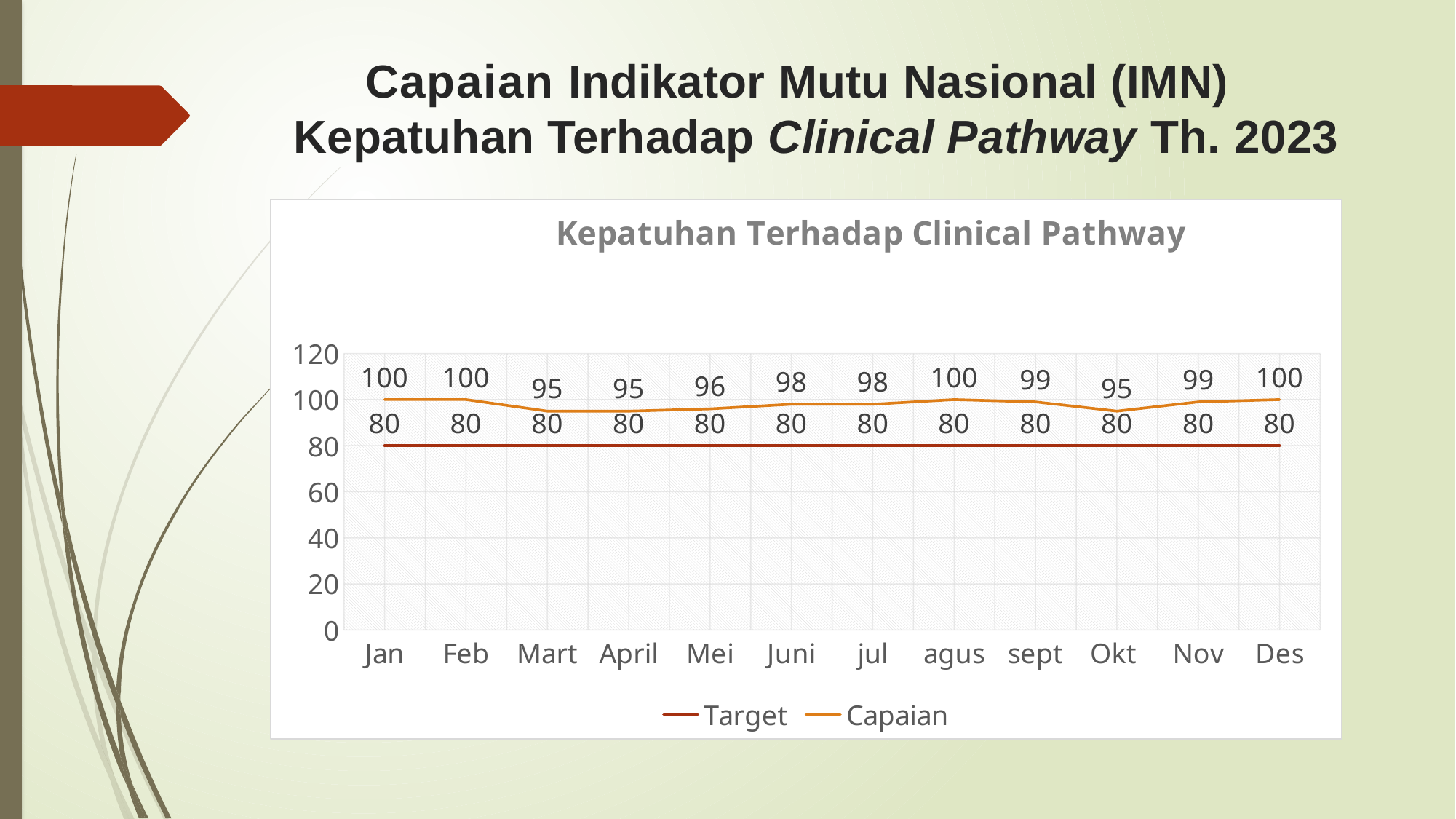
What is the Capaian value for sept? 99 What kind of chart is shown on the slide? Line chart Which month has the lowest Capaian value? Mart, April and Okt (95) How many months are shown on the x axis? 12 What is the Capaian value for Mei? 96 What is the difference between the Capaian values for Feb and Mart? 5 Which is larger, the Capaian value for Juni or the Capaian value for Nov? Nov How many series does the legend list? 2 What is the Capaian value for Okt? 95 What is the Target value for Juni? 80 What is the difference between the Capaian and Target values in Juli? 18 What is the title of the chart? Kepatuhan Terhadap Clinical Pathway